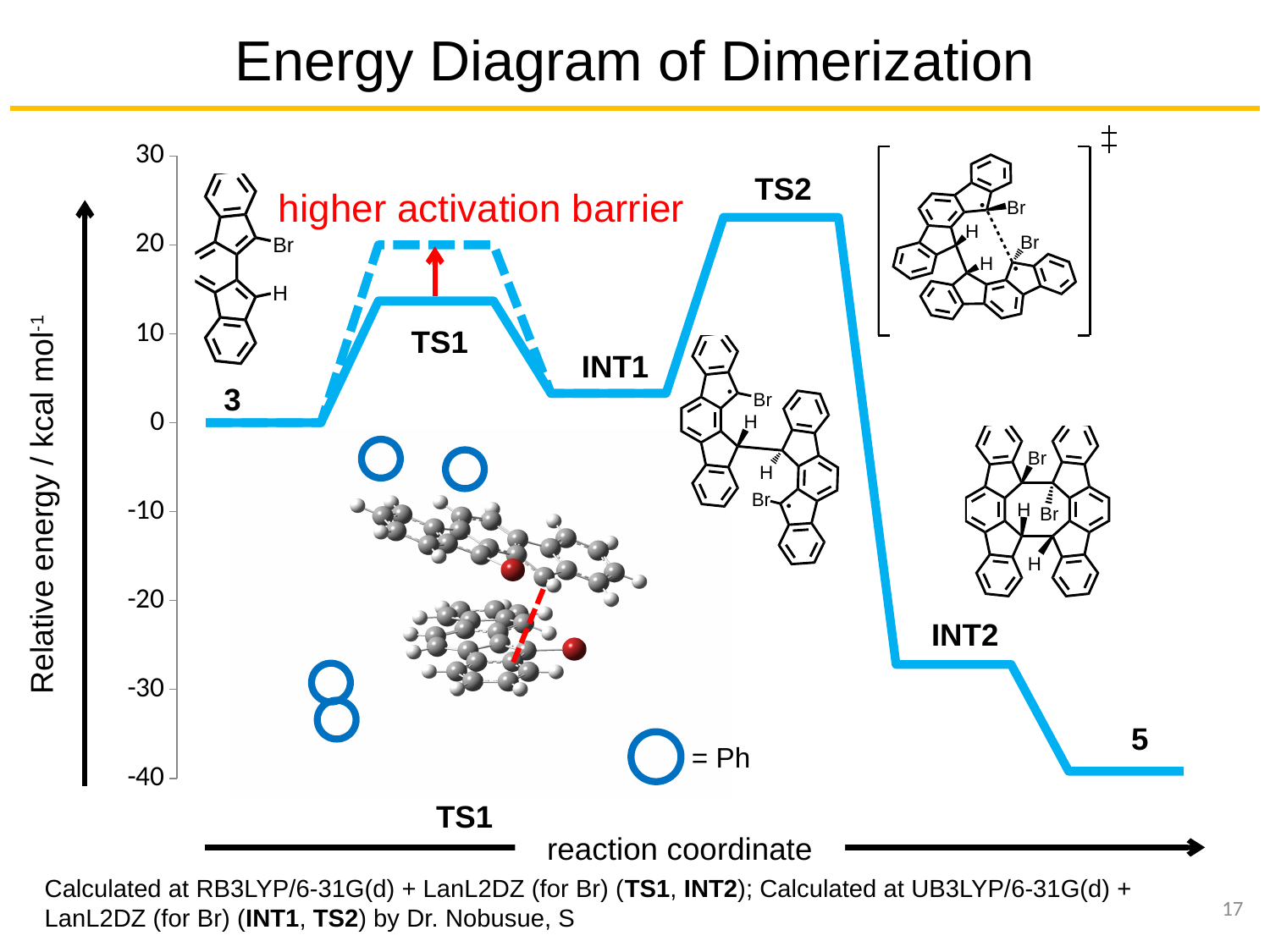
Is the relative energy of TS1 on the solid line greater or less than 10 kcal mol-1? greater What kind of chart is shown on the slide? line chart (energy diagram) How many labeled states (3, TS1, INT1, TS2, INT2, 5) are marked along the reaction coordinate? 6 Which labeled state has the highest relative energy on the solid line? TS2 What is the label of the vertical axis? Relative energy / kcal mol-1 Which has the higher relative energy, TS1 or TS2? TS2 What is the relative energy of the starting compound 3? 0 Which has the higher relative energy, INT1 or INT2? INT1 Is the relative energy of TS2 greater or less than 20 kcal mol-1? greater Is the relative energy of product 5 greater or less than -30 kcal mol-1? less Which labeled state has the lowest relative energy? 5